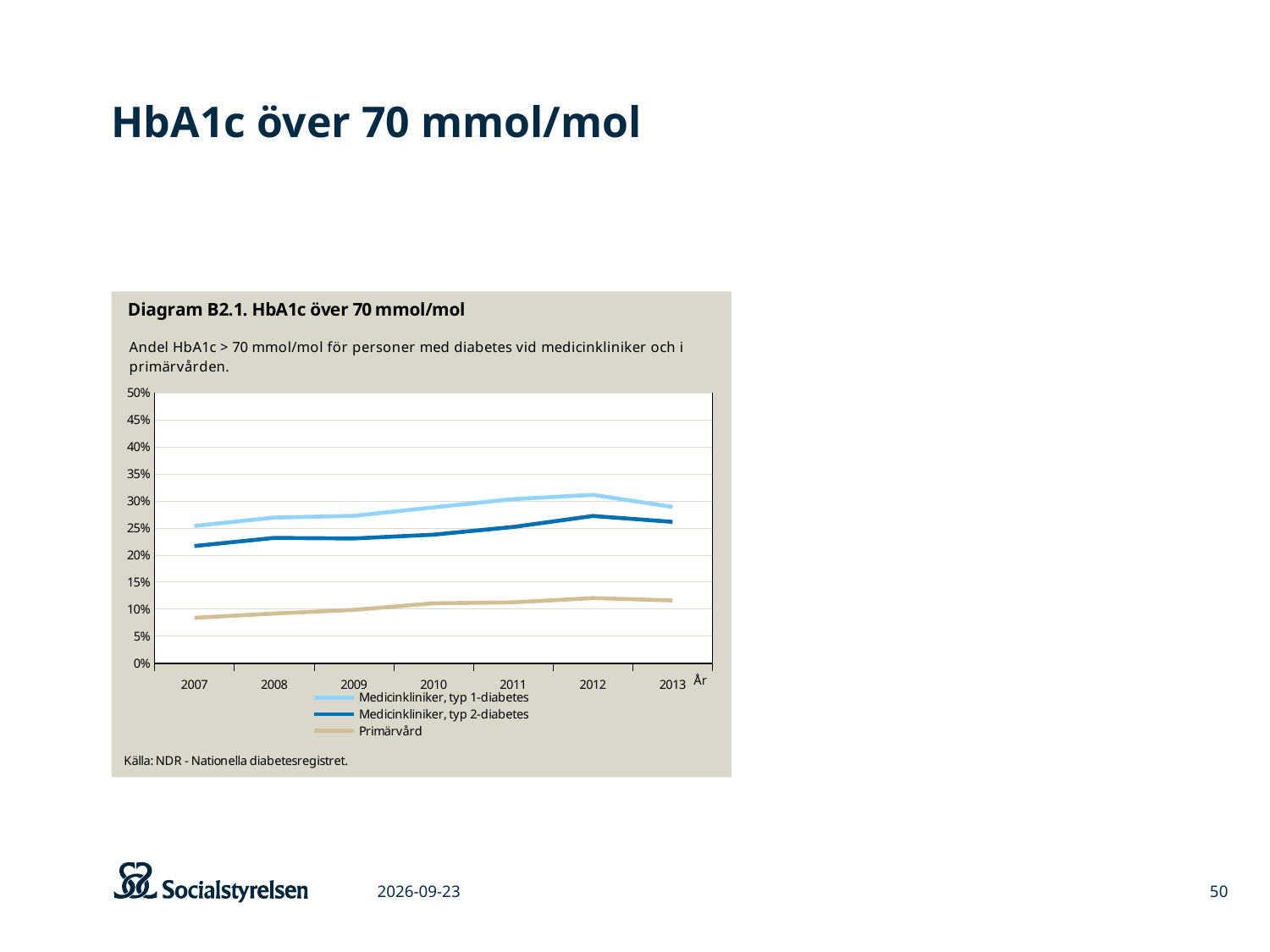
Is the value for Medicinkliniker, typ 1-diabetes in 2012 greater or less than 30%? greater Is the value for Medicinkliniker, typ 2-diabetes in 2007 greater or less than 20%? greater Which is larger in 2010: the value for Medicinkliniker, typ 1-diabetes or Medicinkliniker, typ 2-diabetes? Medicinkliniker, typ 1-diabetes How many series does the legend of the chart list? 3 Which series has the lowest values throughout the chart? Primärvård Is the value for Primärvård in 2007 greater or less than 10%? less How many years are shown on the x axis of the chart? 7 What is the title of the diagram on the slide? Diagram B2.1. HbA1c över 70 mmol/mol What kind of chart is shown in Diagram B2.1? line chart Does the value for Medicinkliniker, typ 1-diabetes rise or fall from 2007 to 2012? rise Which series has the highest values throughout the chart? Medicinkliniker, typ 1-diabetes